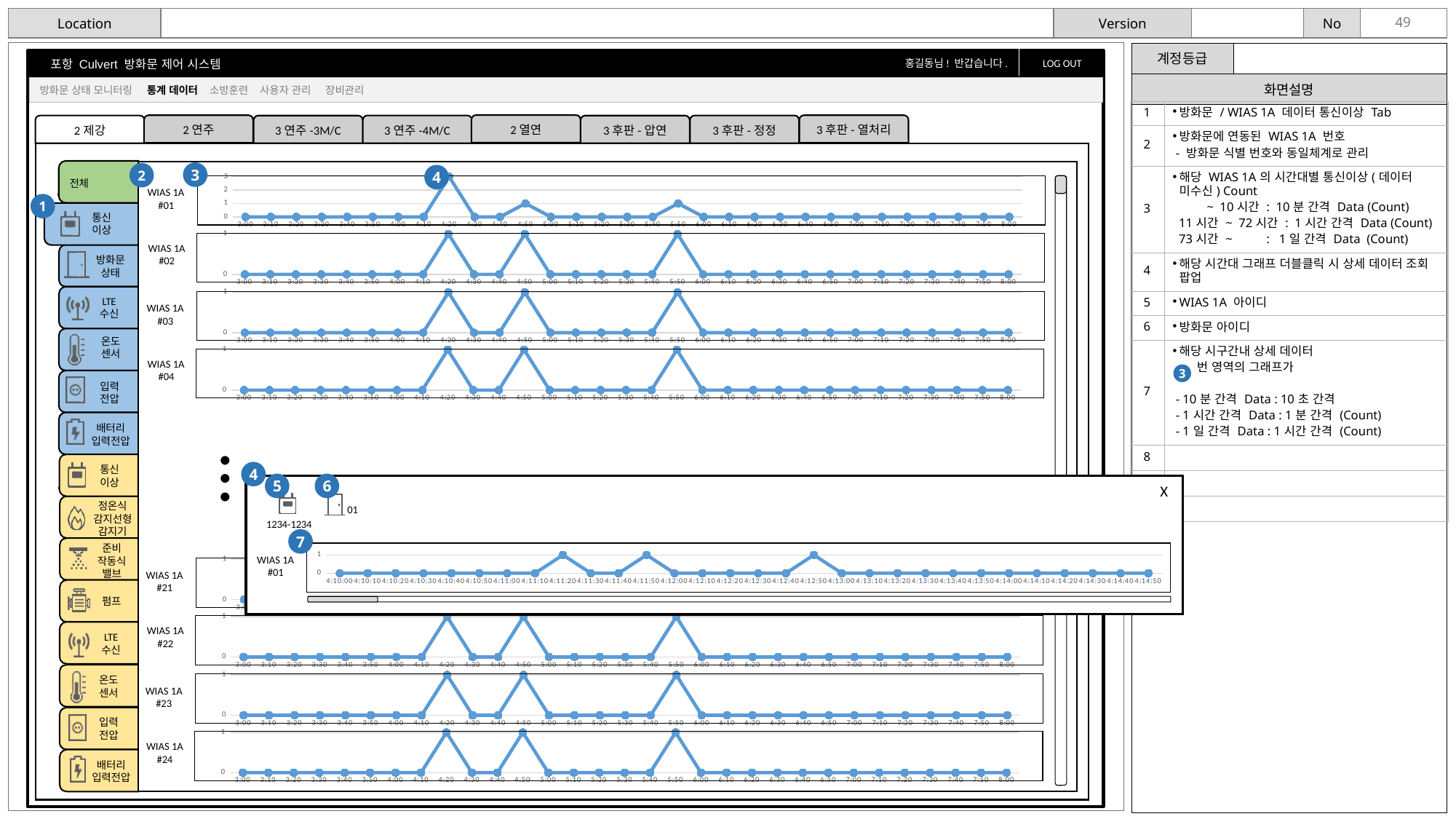
In the WIAS 1A #01 chart at the top of the main panel, what value does the line reach at 4:20? 3 In the WIAS 1A #02 chart, at which three times does the line rise to 1? 4:20, 4:50, 5:50 What is the highest tick on the y axis of the WIAS 1A #01 chart at the top of the main panel? 3 In the popup chart labelled WIAS 1A #01, at which times does the line rise to 1? 4:11:20, 4:11:50, 4:12:50 In the popup chart labelled WIAS 1A #01, what is the first time shown on the x axis? 4:10:00 In the WIAS 1A #01 chart at the top of the main panel, what value does the line reach at 4:50? 1 In the WIAS 1A #02 chart, what is the value at 3:00? 0 In the WIAS 1A #01 chart at the top of the main panel, at which time does the line reach its highest point? 4:20 In the WIAS 1A #01 chart at the top of the main panel, which is larger: the value at 4:20 or the value at 5:50? 4:20 In the WIAS 1A #24 chart at the bottom of the main panel, what is the value at 8:00? 0 In the WIAS 1A #01 chart at the top of the main panel, is the value at 4:20 greater or less than 2? greater What kind of chart is used for the WIAS 1A #01 chart at the top of the main panel? line chart